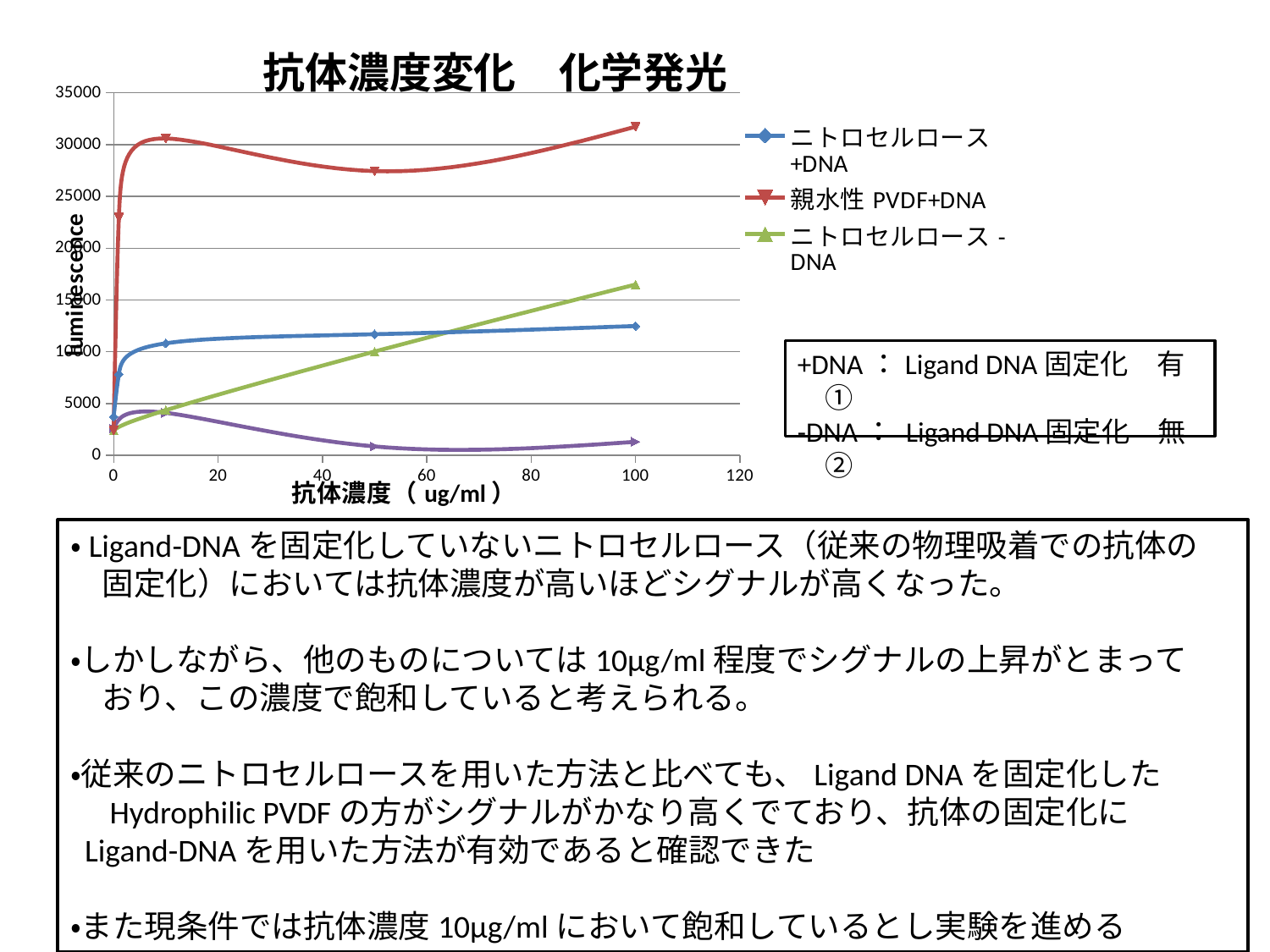
What kind of chart is shown on the slide? line chart Which series has the highest luminescence at an antibody concentration of 100 ug/ml? 親水性 PVDF+DNA Is the value for 親水性 PVDF+DNA at 100 ug/ml greater or less than 30000? greater At 10 ug/ml, which is larger: the value for 親水性 PVDF+DNA or the value for ニトロセルロース+DNA? 親水性 PVDF+DNA Is the value for ニトロセルロース+DNA at 100 ug/ml greater or less than 15000? less What is the title of the chart? 抗体濃度変化 化学発光 Does the value for ニトロセルロース -DNA rise or fall as antibody concentration increases? rise At 100 ug/ml, which is larger: the value for ニトロセルロース+DNA or the value for ニトロセルロース -DNA? ニトロセルロース -DNA How many series does the chart legend list? 3 Is the value for ニトロセルロース -DNA at 100 ug/ml greater or less than 15000? greater What is the label of the x axis of the chart? 抗体濃度（ug/ml）